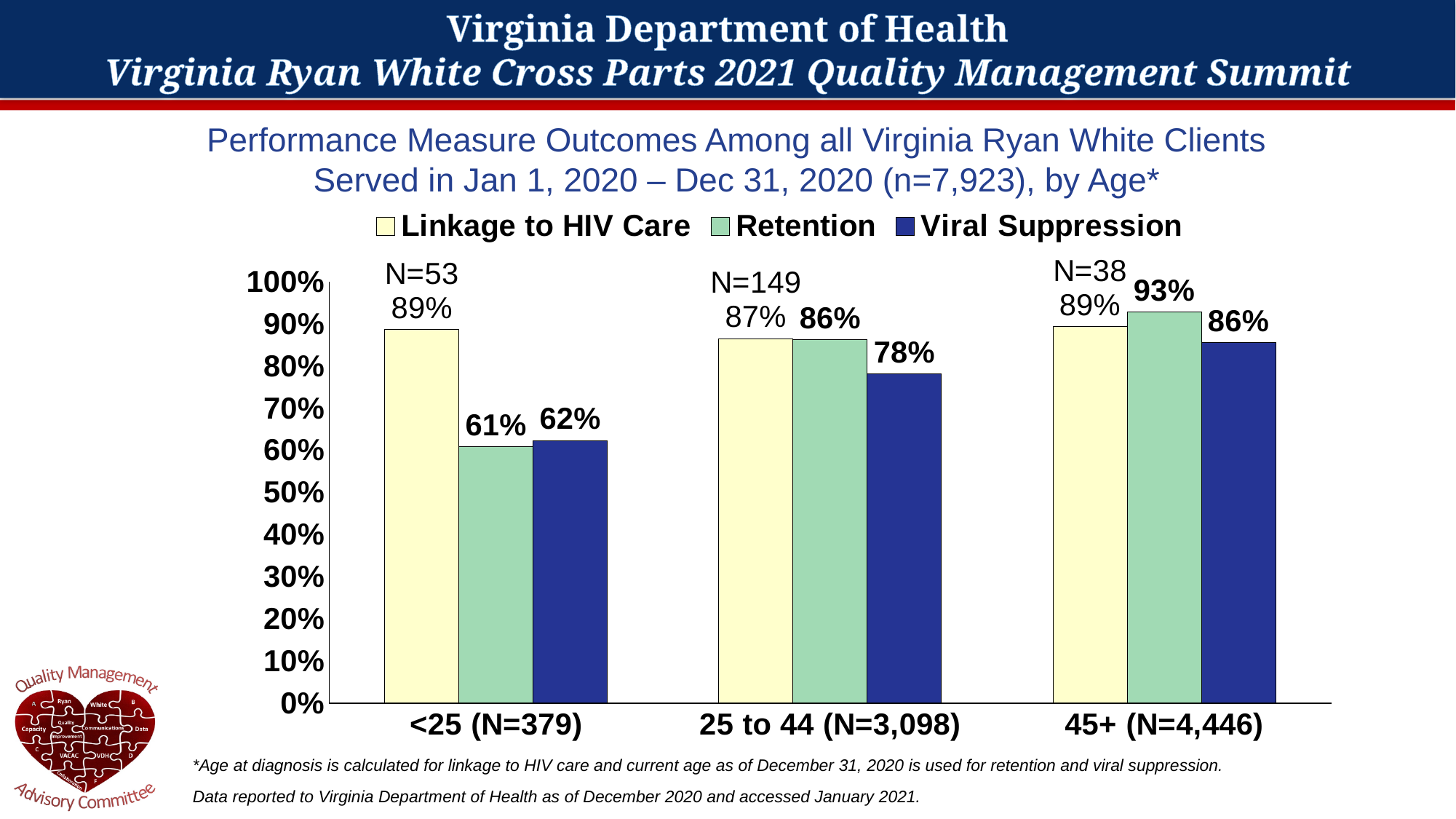
Do the Viral Suppression values rise or fall across the age groups from <25 to 45+? Rise How many age groups are shown on the x axis? 3 What is the Linkage to HIV Care value for the 25 to 44 (N=3,098) age group? 87% Which age group has the highest Viral Suppression value? 45+ (N=4,446) Is the Viral Suppression value for the 25 to 44 (N=3,098) age group greater or less than 70%? greater What is the Viral Suppression value for the <25 (N=379) age group? 62% How many series does the legend list? 3 Which is larger for the 25 to 44 (N=3,098) age group: Retention or Viral Suppression? Retention What is the difference between the Retention values for the 45+ (N=4,446) and <25 (N=379) age groups? 32% What is the Retention value for the 45+ (N=4,446) age group? 93% What kind of chart is shown on the slide? Bar chart Which age group has the lowest Retention value? <25 (N=379)